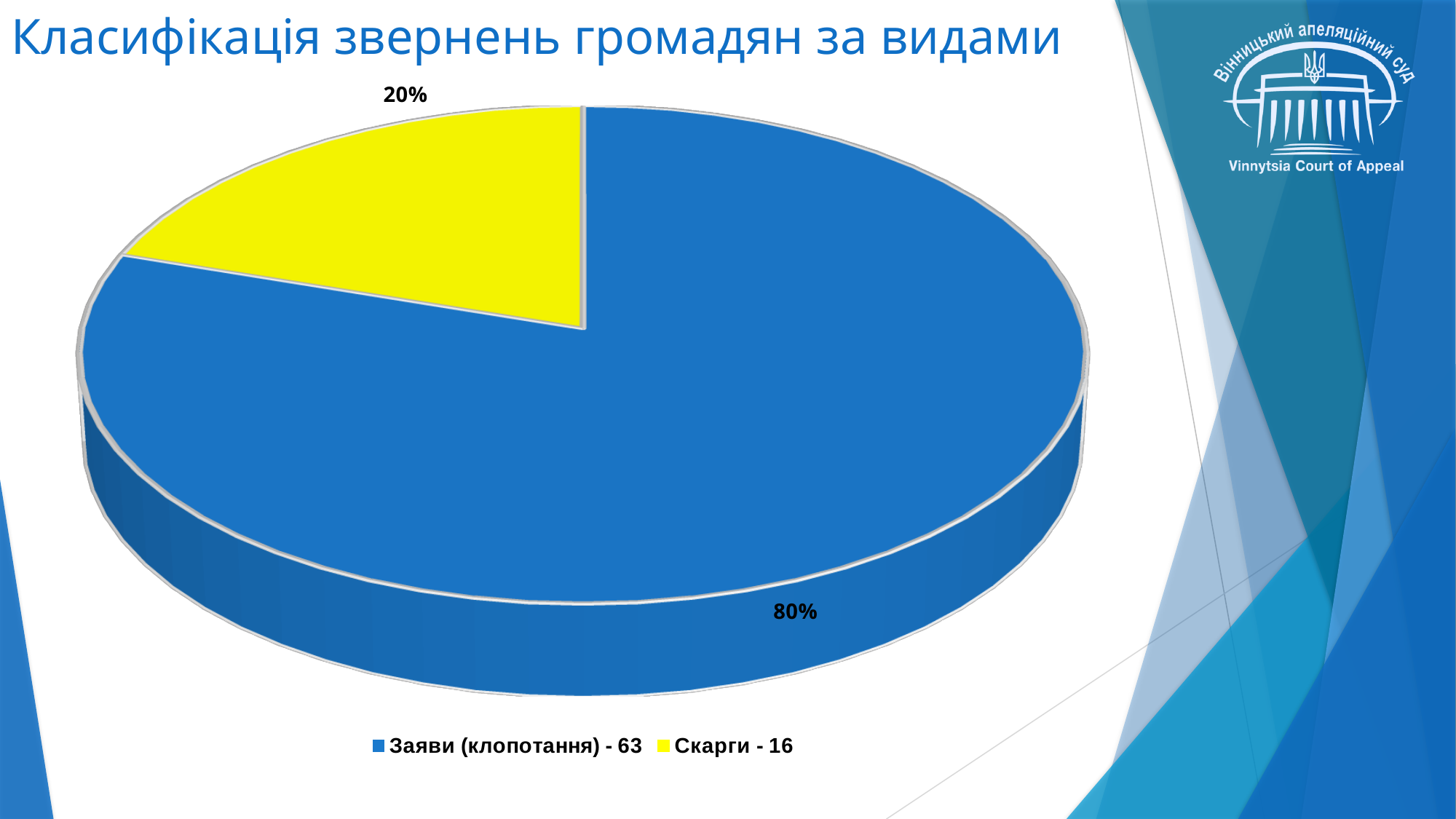
What kind of chart is shown on the slide? pie chart What share of the pie does the 'Скарги - 16' slice represent? 20% How many slices does the pie chart have? 2 How many entries does the legend list? 2 What is the title of the slide? Класифікація звернень громадян за видами What share of the pie does the 'Заяви (клопотання) - 63' slice represent? 80% Which category has the largest slice of the pie? Заяви (клопотання) - 63 What is the difference in percentage points between the 'Заяви (клопотання)' slice and the 'Скарги' slice? 60 percentage points Which is larger: the share for 'Заяви (клопотання)' or the share for 'Скарги'? Заяви (клопотання) What colour is the 'Скарги - 16' slice? yellow Which category has the smallest slice of the pie? Скарги - 16